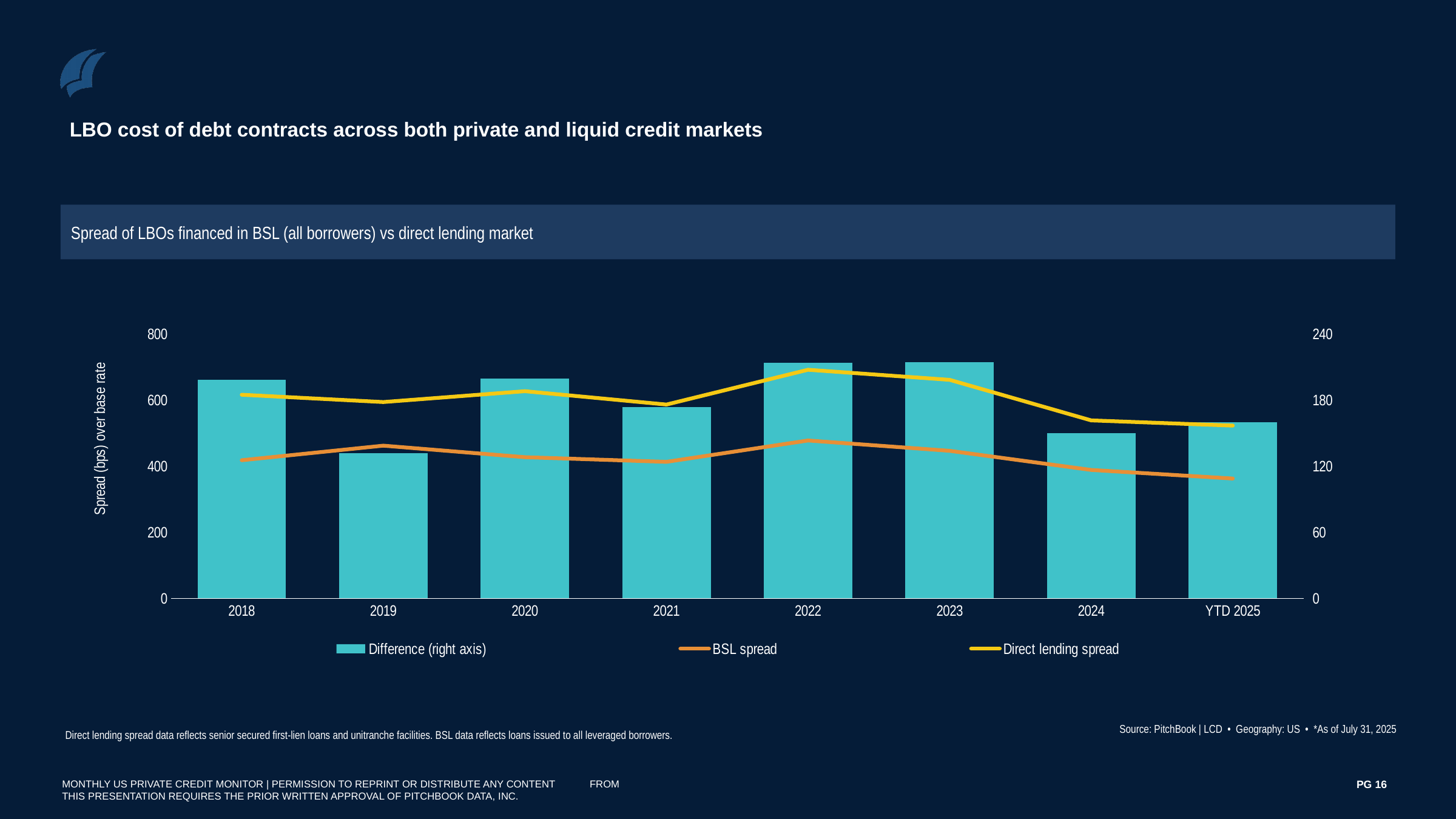
Is the Difference bar for 2019 greater or less than 180 on the right axis? less Which series is plotted as bars on the right axis? Difference (right axis) Does the Direct lending spread rise or fall from 2023 to YTD 2025? Fall In which year is the Difference bar the lowest? 2019 Is the Direct lending spread for 2022 greater or less than 600? greater How many series does the chart's legend list? 3 What is the title of the chart? Spread of LBOs financed in BSL (all borrowers) vs direct lending market In which year does the Direct lending spread line reach its highest point? 2022 How many time periods are shown on the x axis of the chart? 8 What kind of chart is shown on the slide? A combined bar and line chart Which is larger in 2018, the Direct lending spread or the BSL spread? Direct lending spread Is the BSL spread for 2019 greater or less than 400? greater